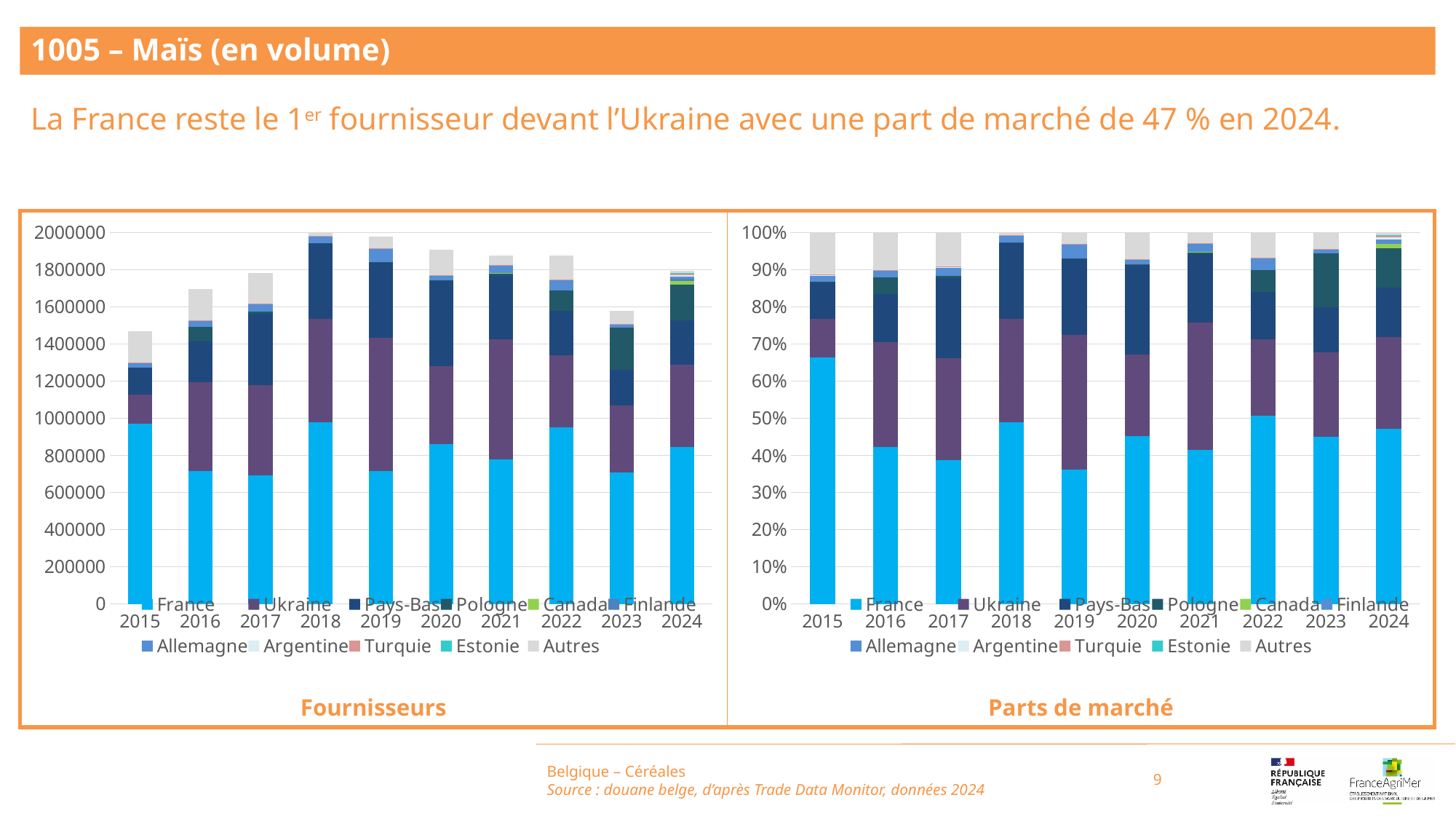
In the 'Fournisseurs' chart, is the total stacked bar for 2018 greater or less than 1800000? greater In the 'Parts de marché' chart, is the share for France in 2015 greater or less than 60%? greater In the 'Fournisseurs' chart, is the value for France in 2015 greater or less than 800000? greater How many series does the legend of the 'Fournisseurs' chart list? 11 How many years are shown on the x axis of the 'Parts de marché' chart? 10 What kind of chart is the 'Fournisseurs' chart on the left? Stacked bar chart In the 'Fournisseurs' chart, which year has the lowest total stacked bar? 2015 In the 'Parts de marché' chart, in which year is France's share the highest? 2015 In the 'Fournisseurs' chart, is the France segment larger in 2022 or in 2023? 2022 Which series is shown in light blue at the bottom of each stacked bar in both charts? France